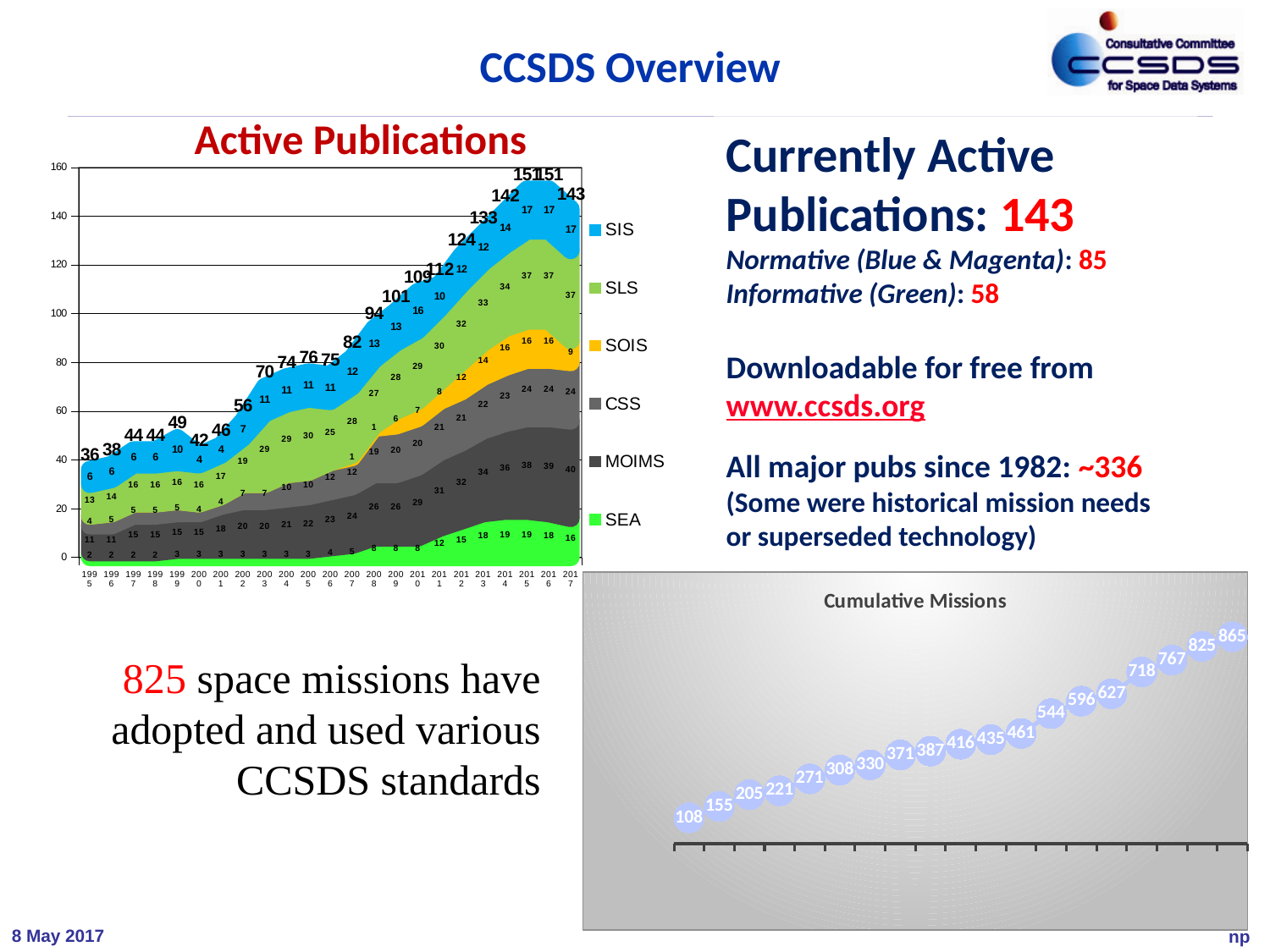
In the Cumulative Missions chart, what is the lowest value shown? 108 How many data points are plotted in the Cumulative Missions chart? 19 In the Active Publications chart, what is the total number of active publications in 2017? 143 In the Active Publications chart, what is the total for 2010? 109 How many series does the legend of the Active Publications chart list? 6 In the Active Publications chart, which year has the lowest total of active publications? 1995 What kind of chart is the Active Publications chart? stacked area chart In the Active Publications chart, what is the SEA value for 2017? 16 In the Cumulative Missions chart, do the values rise or fall along the x axis? rise In the Active Publications chart, which year has the larger total, 2008 or 2009? 2009 In the Active Publications chart, what is the difference between the 2017 total (143) and the 1995 total (36)? 107 In the Cumulative Missions chart, what is the highest value shown? 865